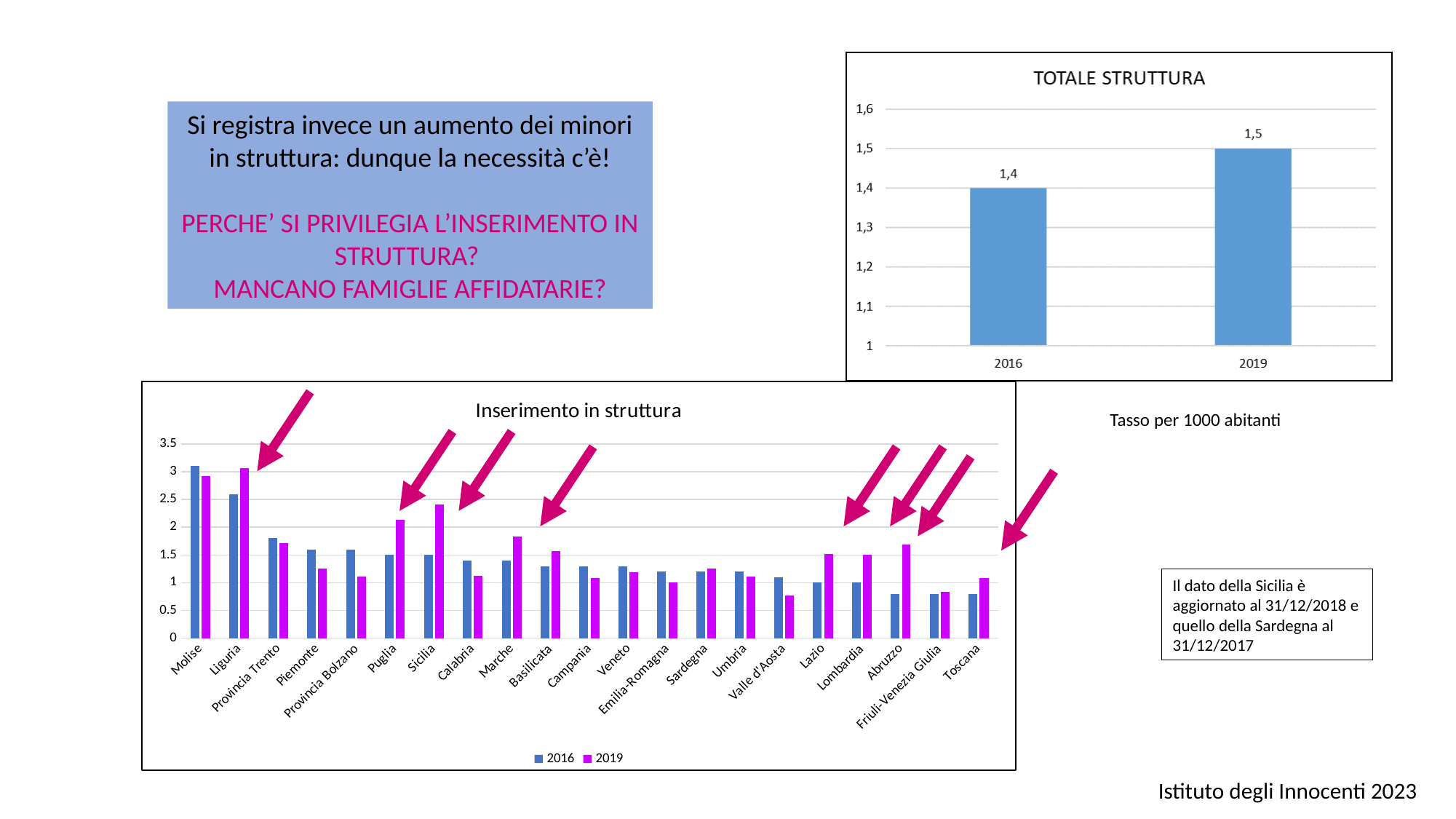
In the TOTALE STRUTTURA chart, what is the value for 2016? 1,4 How many series does the legend of the Inserimento in struttura chart list? 2 In the TOTALE STRUTTURA chart, which year has the higher value? 2019 In the TOTALE STRUTTURA chart, what is the difference between the 2019 and 2016 values? 0,1 In the Inserimento in struttura chart, which colour represents the 2019 series? Magenta How many bars are shown in the TOTALE STRUTTURA chart? 2 In the Inserimento in struttura chart, is the 2016 value for Toscana greater or less than 1? less In the TOTALE STRUTTURA chart, what is the value for 2019? 1,5 In the Inserimento in struttura chart, is the 2019 value for Sicilia greater or less than 2? greater What kind of chart is the TOTALE STRUTTURA chart? Bar chart In the Inserimento in struttura chart, which region has the highest 2016 value? Molise How many regions are shown on the x axis of the Inserimento in struttura chart? 21